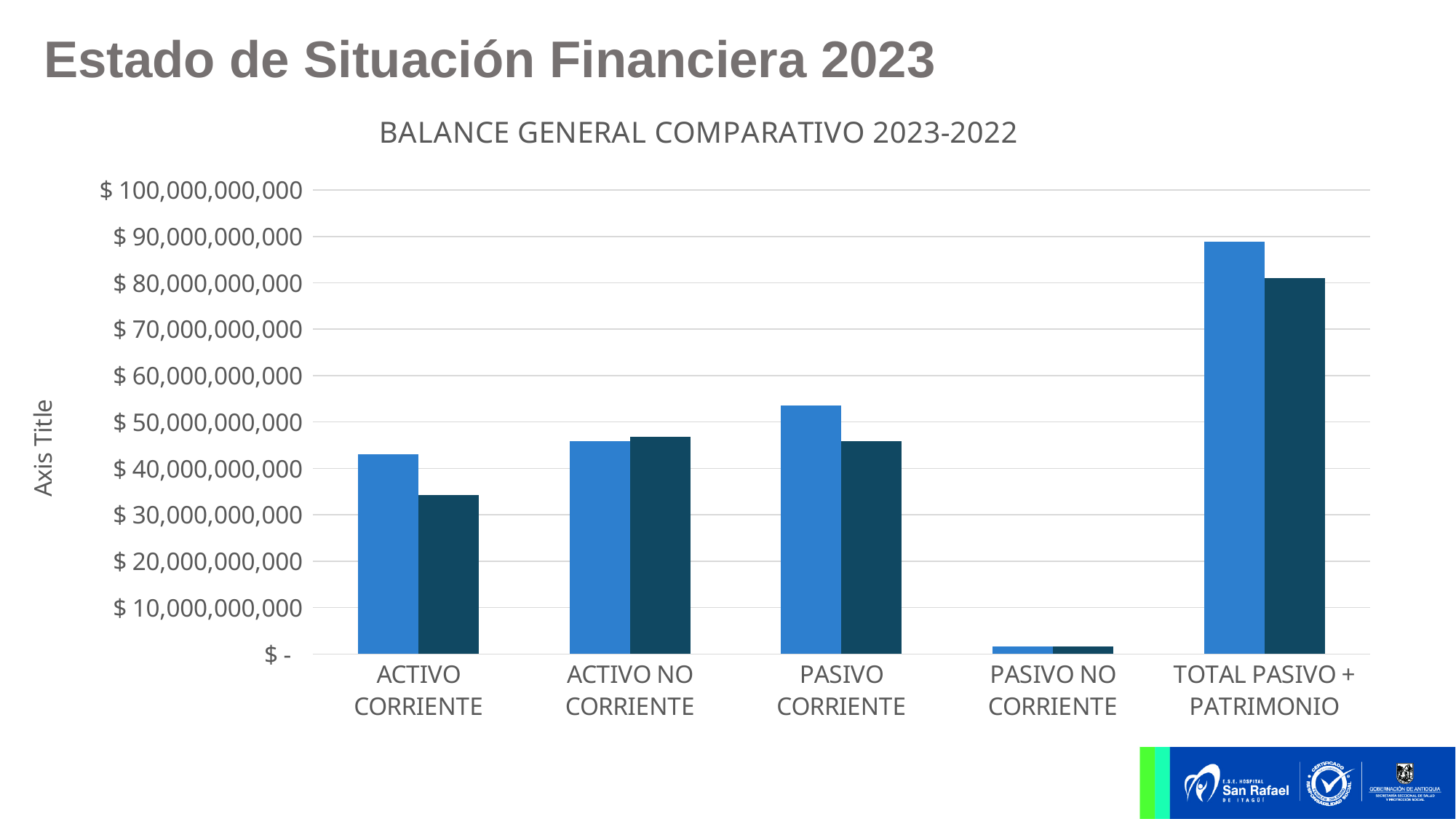
Which category has the tallest bars in the chart? TOTAL PASIVO + PATRIMONIO How many categories are shown on the x axis of the chart? 5 Is the darker blue bar for TOTAL PASIVO + PATRIMONIO greater or less than $ 90,000,000,000? less For ACTIVO CORRIENTE, which bar is taller, the lighter blue one or the darker blue one? the lighter blue one Is the darker blue bar for ACTIVO CORRIENTE greater or less than $ 40,000,000,000? less What is the title of the chart? BALANCE GENERAL COMPARATIVO 2023-2022 Is the lighter blue bar for PASIVO CORRIENTE greater or less than $ 50,000,000,000? greater What text is shown as the vertical axis title of the chart? Axis Title What kind of chart is shown on the slide? bar chart Which category has the shortest bars in the chart? PASIVO NO CORRIENTE